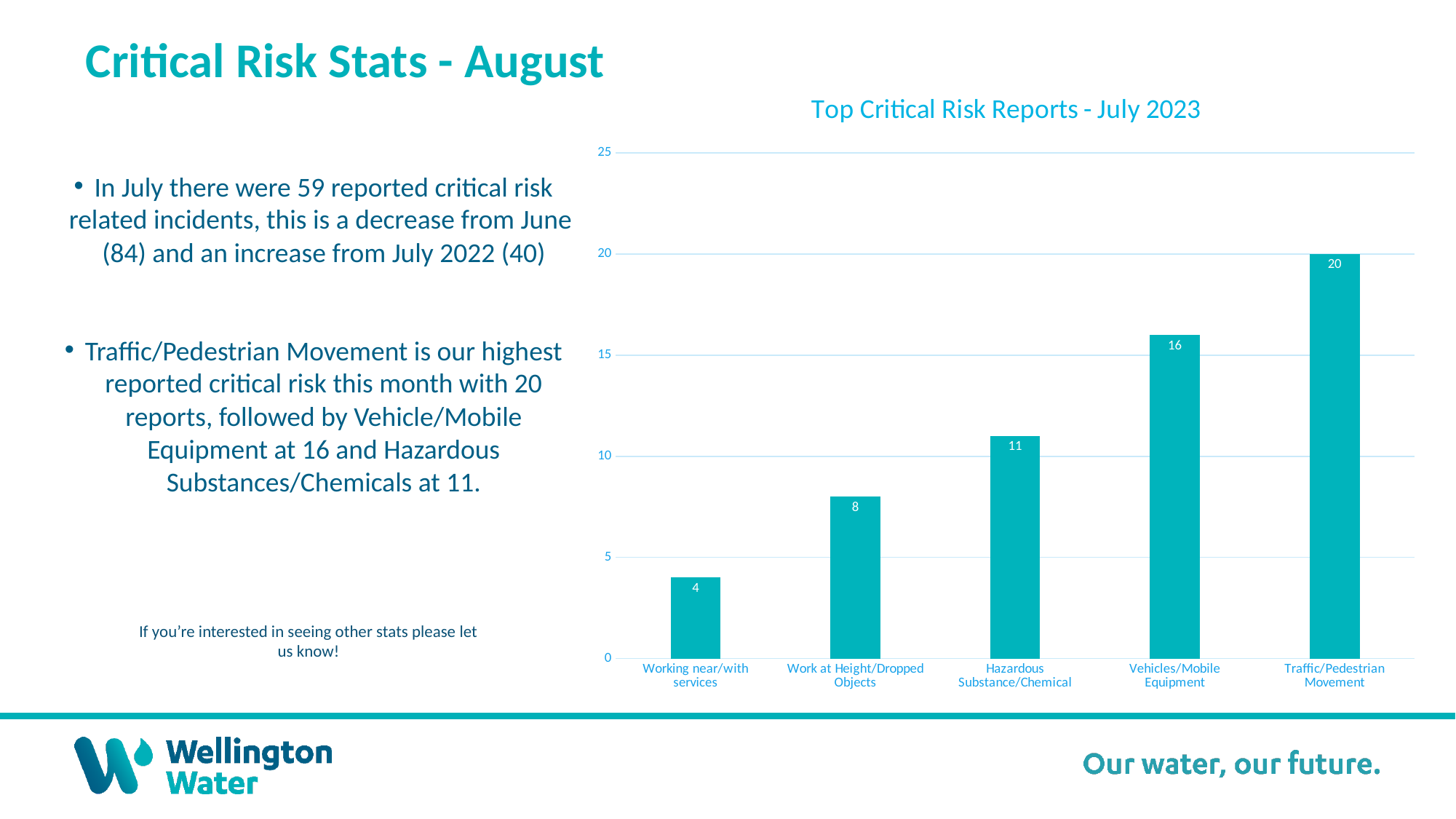
Is the value for Vehicles/Mobile Equipment greater or less than 15? greater Which is larger, Work at Height/Dropped Objects or Vehicles/Mobile Equipment? Vehicles/Mobile Equipment How many categories are shown on the chart? 5 What kind of chart is shown on the slide? bar chart What is the difference between Hazardous Substance/Chemical and Work at Height/Dropped Objects? 3 What is the title of the chart? Top Critical Risk Reports - July 2023 What is the value for Traffic/Pedestrian Movement? 20 Which category has the lowest value? Working near/with services What is the difference between Traffic/Pedestrian Movement and Vehicles/Mobile Equipment? 4 What is the value for Working near/with services? 4 What is the value for Hazardous Substance/Chemical? 11 Which category has the highest value? Traffic/Pedestrian Movement